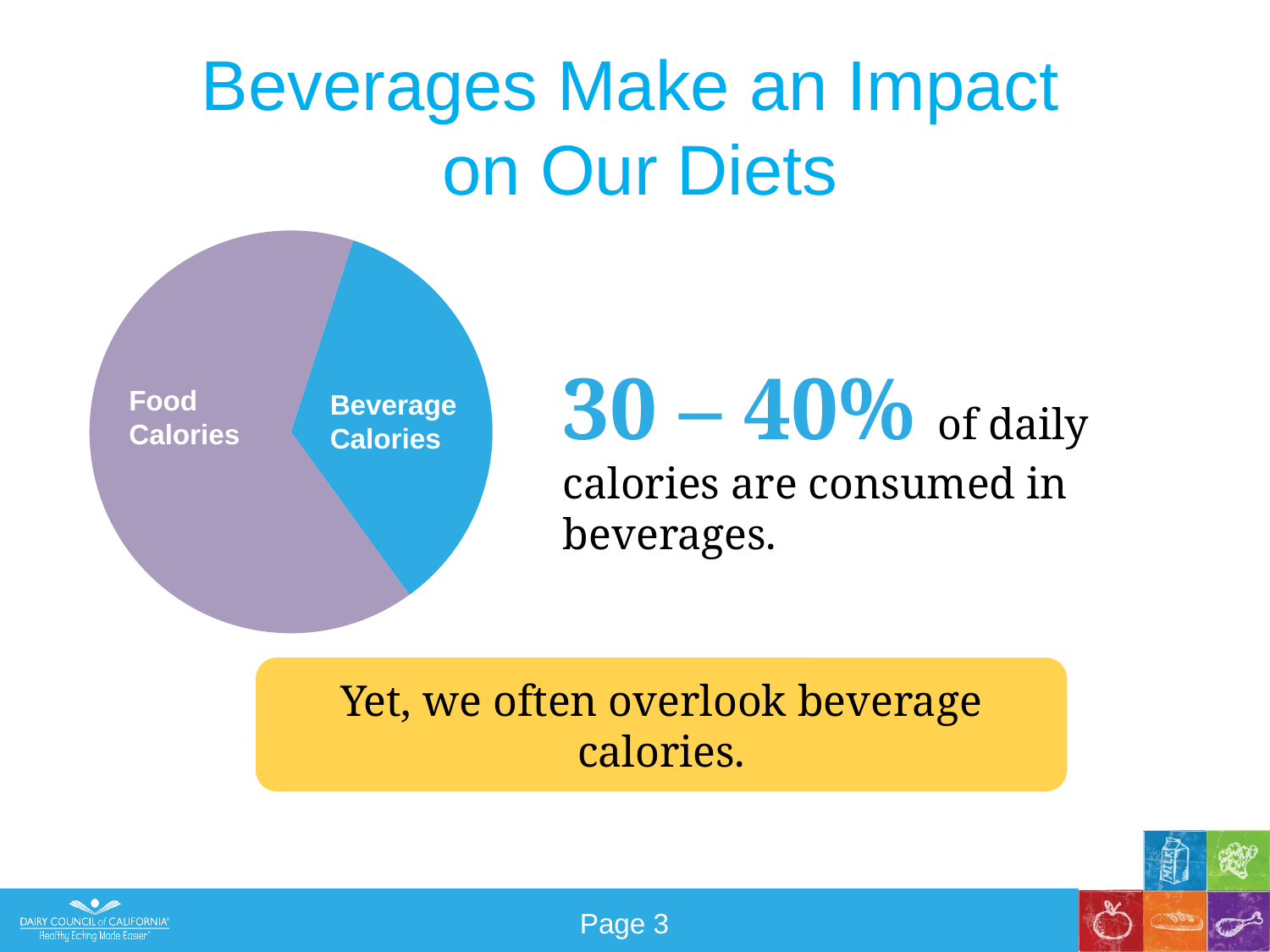
Which slice of the pie chart is the largest? Food Calories Which slice is larger in the pie chart, Food Calories or Beverage Calories? Food Calories How many slices does the pie chart have? 2 What kind of chart is shown on the slide? pie chart Which slice of the pie chart is the smallest? Beverage Calories What colour is the Beverage Calories slice in the pie chart? blue What are the labels of the two slices in the pie chart? Food Calories and Beverage Calories